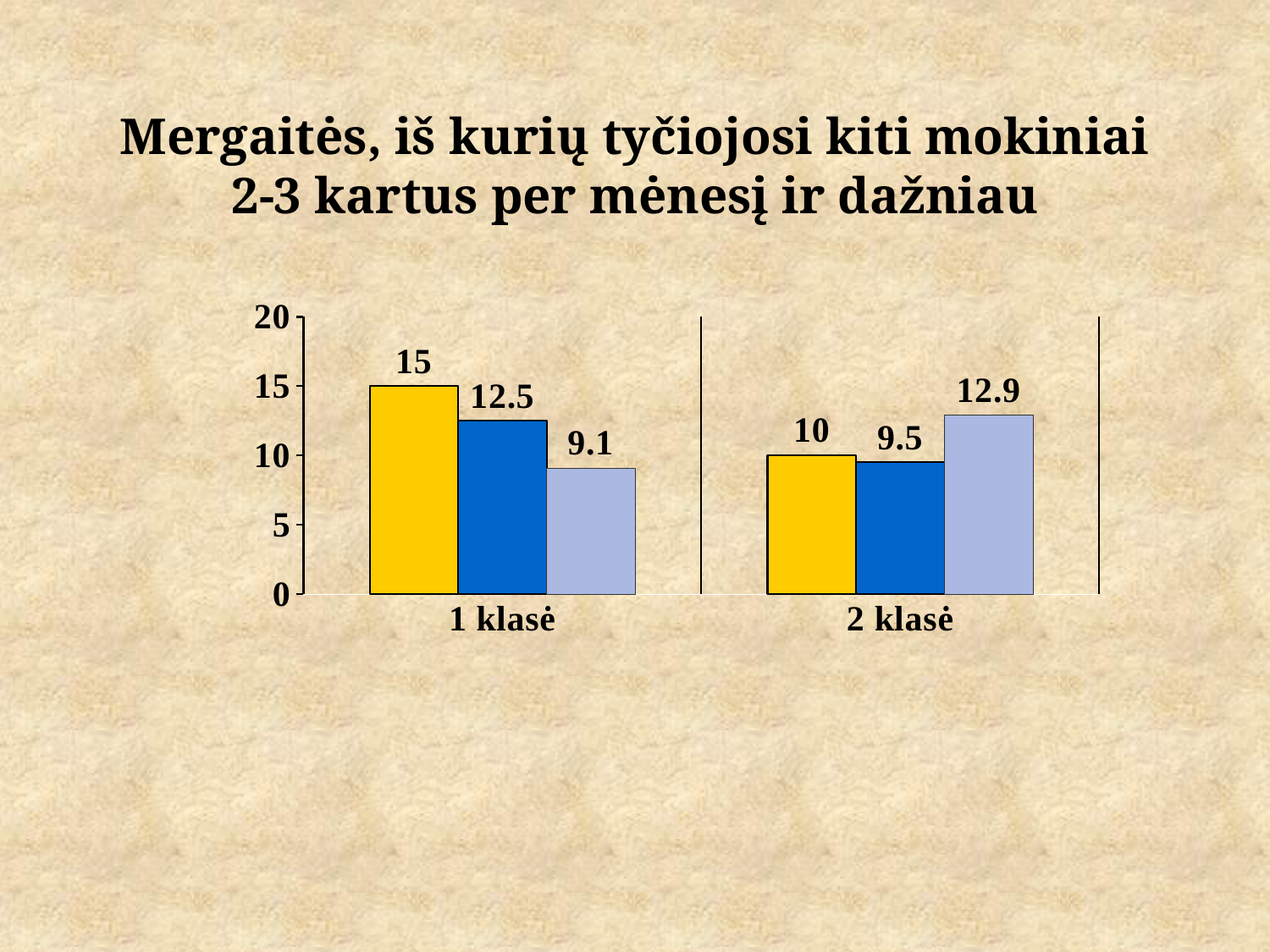
What kind of chart is shown on the slide? Bar chart Which bar is the lowest in the 2 klasė group? The dark blue bar (9.5) What is the difference between the light blue bar values for 2 klasė and 1 klasė? 3.8 Which is larger: the dark blue bar for 1 klasė or the dark blue bar for 2 klasė? 1 klasė (12.5) What is the title of the slide? Mergaitės, iš kurių tyčiojosi kiti mokiniai 2-3 kartus per mėnesį ir dažniau What is the value of the yellow bar for 1 klasė? 15 Which bar is the highest in the 1 klasė group? The yellow bar (15) What is the value of the light blue bar for 2 klasė? 12.9 What is the value of the light blue bar for 1 klasė? 9.1 What is the difference between the yellow bar values for 1 klasė and 2 klasė? 5 How many categories are shown on the x axis? 2 What is the value of the dark blue bar for 2 klasė? 9.5